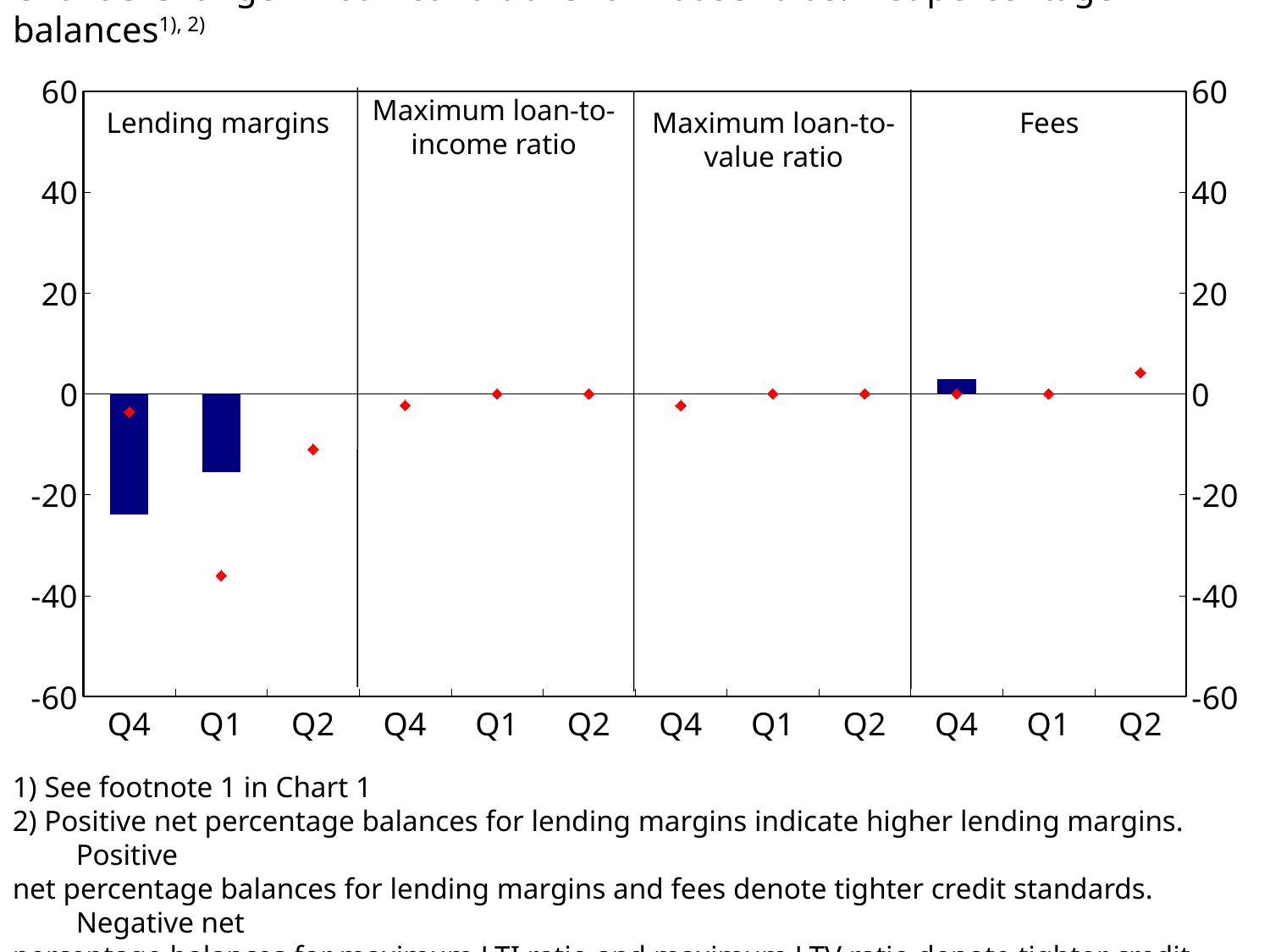
In the Fees panel, is the bar for Q4 greater or less than 20? less In the Lending margins panel, is the bar for Q1 greater or less than -20? greater How many quarters are shown within each panel of the chart? 3 How many panels (categories) does the chart have along the x axis? 4 What is the label of the fourth (rightmost) panel of the chart? Fees What kind of chart is shown on the slide? combination bar and line chart (bars with diamond markers) Which panel contains the lowest bar in the chart? Lending margins In the Lending margins panel, which bar is lower, Q4 or Q1? Q4 In the Lending margins panel, is the bar for Q4 greater or less than -20? less Which panel contains the only bar above zero? Fees In the Lending margins panel, which quarter has the lowest red diamond? Q1